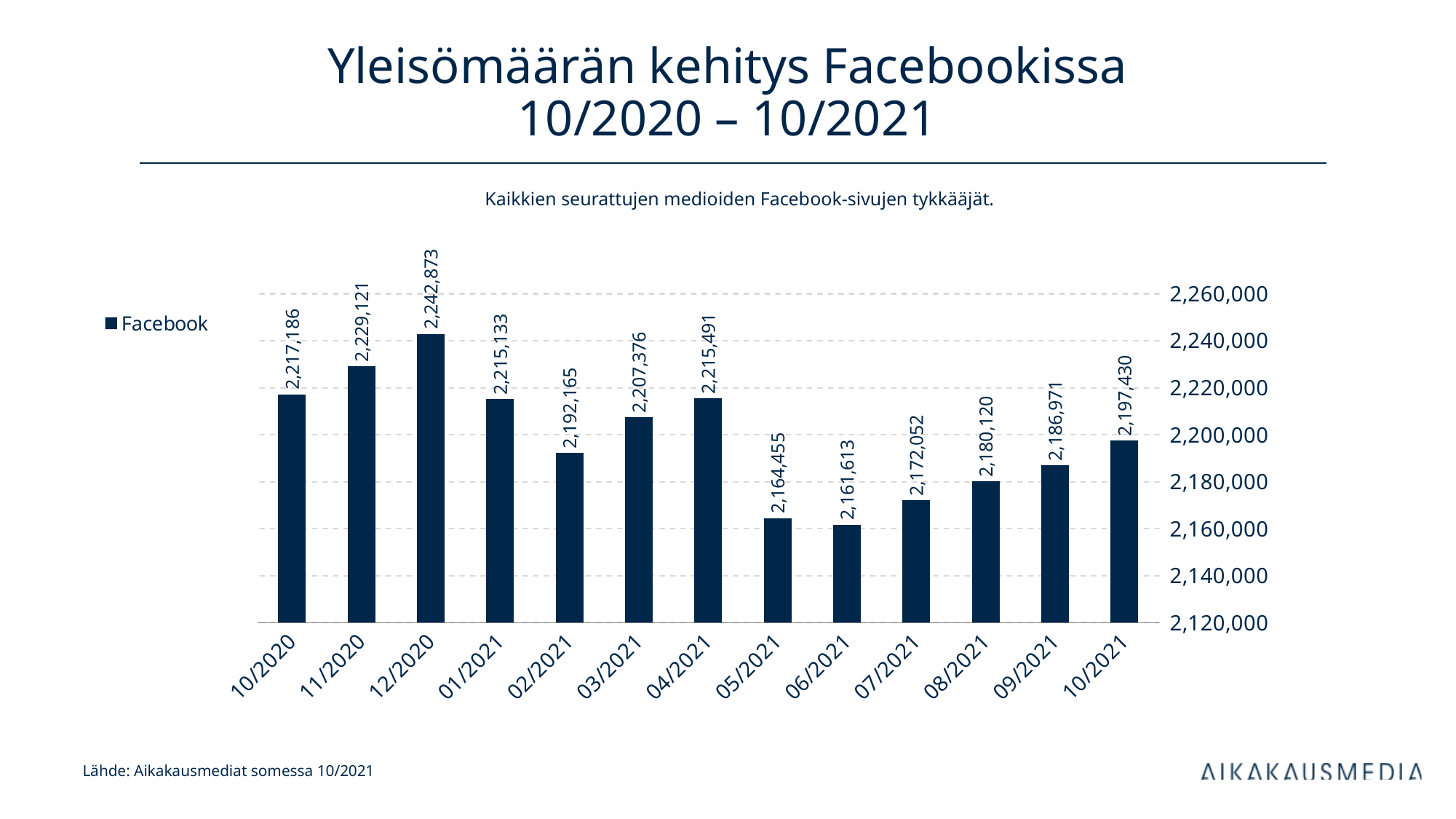
What kind of chart is shown on the slide? bar chart How many months are shown on the x axis? 13 Which month has the highest value? 12/2020 Which is larger, the value for 11/2020 or the value for 04/2021? 11/2020 What is the value for 06/2021? 2,161,613 What is the difference between the values for 12/2020 and 06/2021? 81,260 What series does the legend list? Facebook What is the value for 10/2021? 2,197,430 Which month has the lowest value? 06/2021 What is the difference between the values for 10/2020 and 10/2021? 19,756 Is the value for 05/2021 greater or less than 2,180,000? less What is the value for 12/2020? 2,242,873